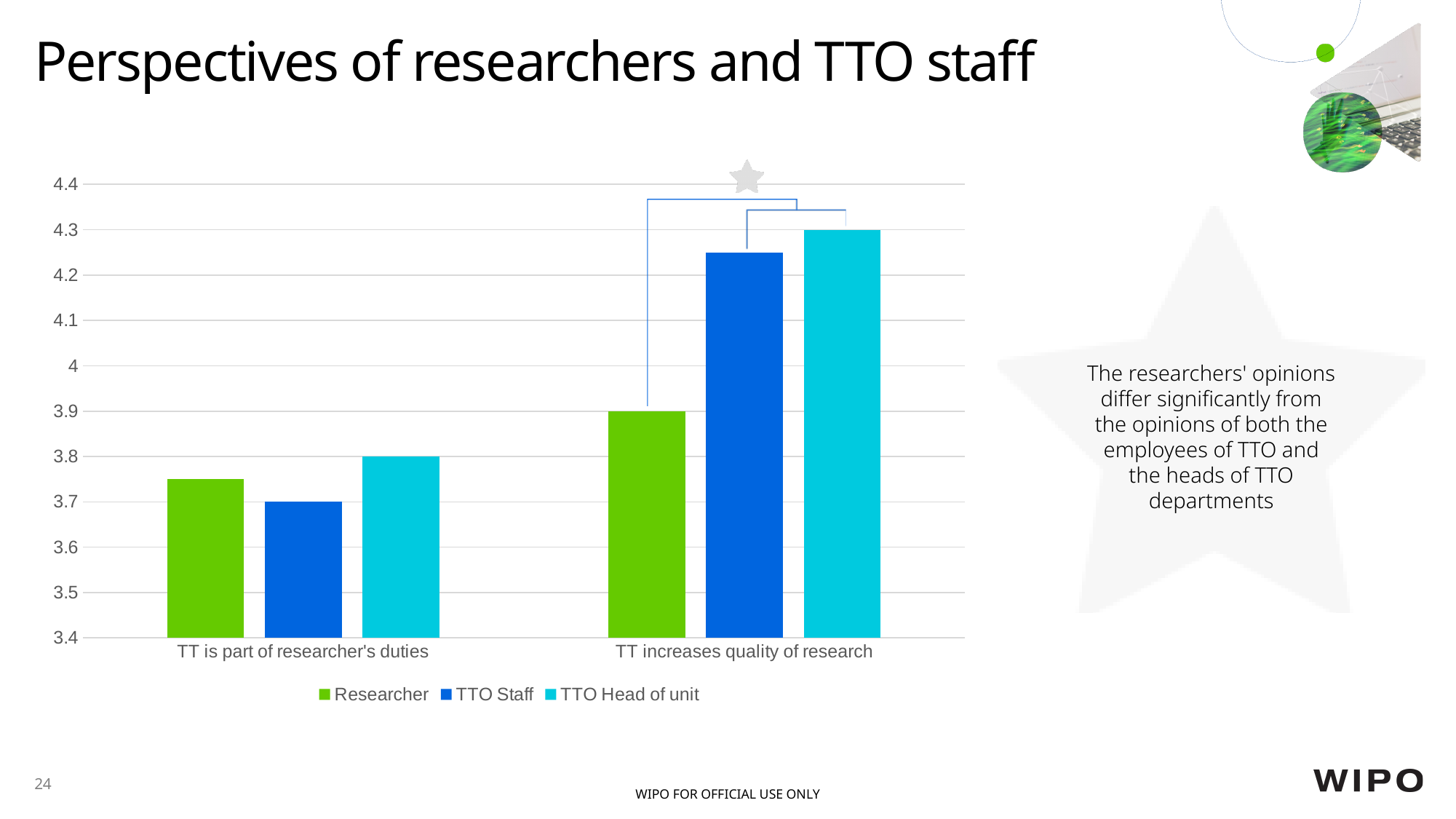
What kind of chart is shown on the slide? Bar chart What is the value for TTO Head of unit in the category "TT is part of researcher's duties"? 3.8 Is the value for Researcher in the category "TT is part of researcher's duties" greater or less than 3.7? greater What is the value for Researcher in the category "TT increases quality of research"? 3.9 What is the value for TTO Staff in the category "TT is part of researcher's duties"? 3.7 What is the value for TTO Head of unit in the category "TT increases quality of research"? 4.3 How many series does the legend list? 3 Is the value for TTO Staff in the category "TT increases quality of research" greater or less than 4.2? greater What is the difference between the TTO Head of unit and Researcher values in the category "TT increases quality of research"? 0.4 What is the difference between the TTO Head of unit and TTO Staff values in the category "TT is part of researcher's duties"? 0.1 Is the Researcher value larger for "TT is part of researcher's duties" or for "TT increases quality of research"? TT increases quality of research Which series has the lowest value in the category "TT increases quality of research"? Researcher